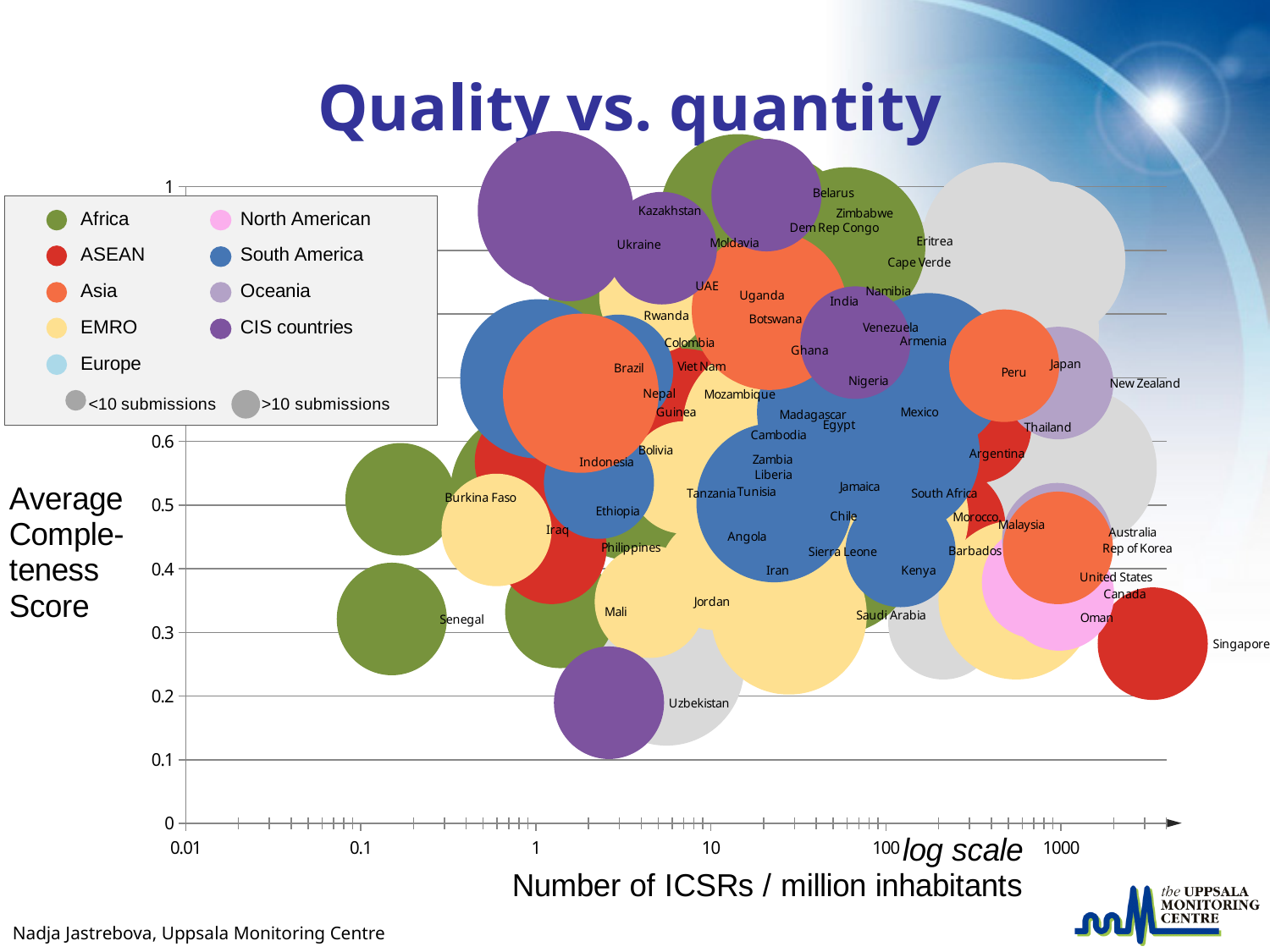
Is the number of ICSRs per million inhabitants for Senegal greater or less than 1? less What is the title of the chart? Quality vs. quantity Which labelled country has the lowest Average Completeness Score? Uzbekistan Is the Average Completeness Score for Kazakhstan greater or less than 0.8? greater Which has a higher Average Completeness Score, Senegal or Uzbekistan? Senegal What kind of chart is shown on the slide? Bubble chart Which colour represents CIS countries in the legend? Purple Is the Average Completeness Score for Burkina Faso greater or less than 0.4? greater Which labelled country has the highest number of ICSRs per million inhabitants? Singapore How many regional groups does the colour legend list? 9